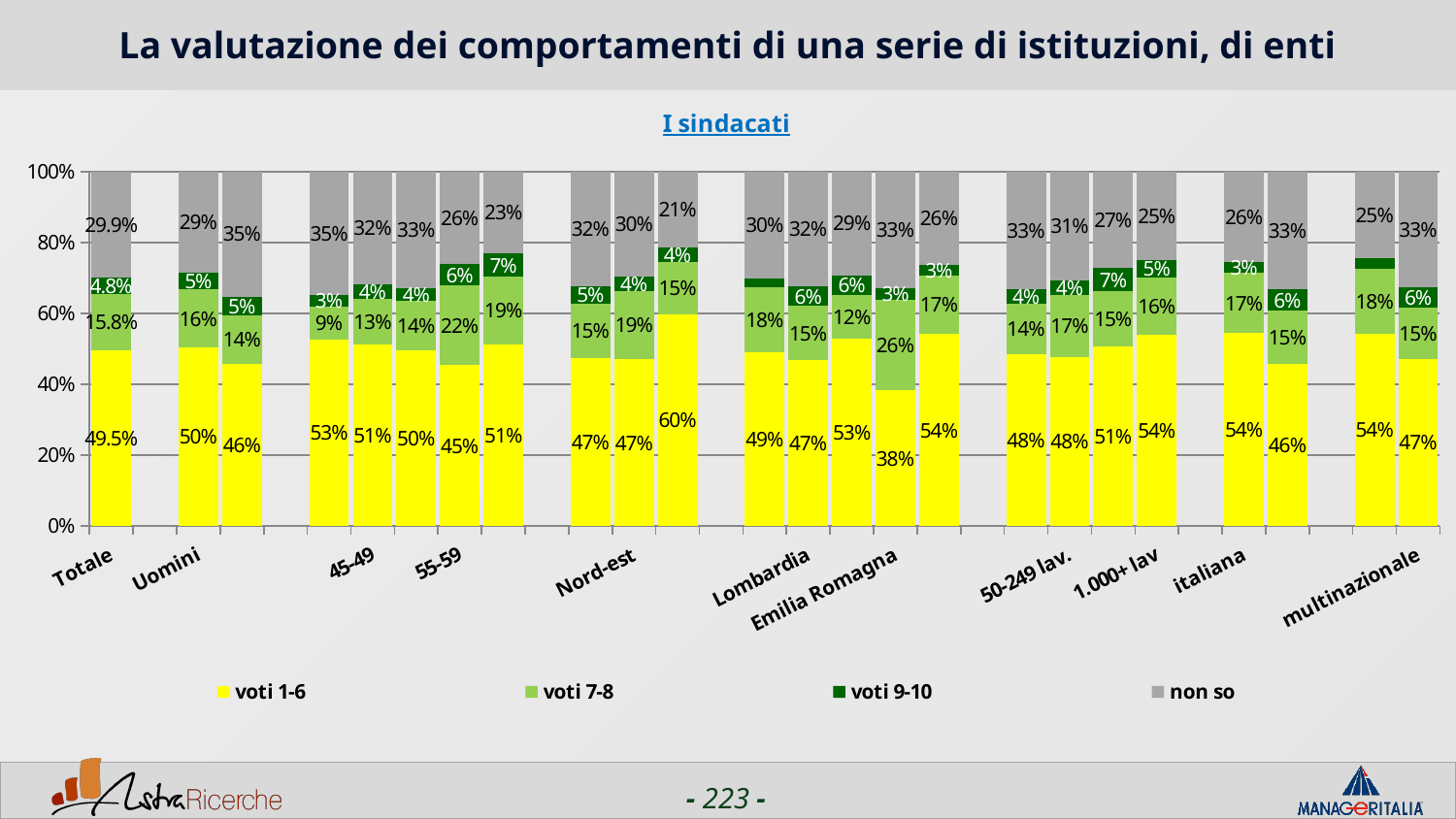
What is the 'non so' value for Totale? 29.9% What is the highest 'voti 1-6' value shown in any bar? 60% What kind of chart is shown on the slide? stacked bar chart Which has the larger 'non so' value, Totale or Uomini? Totale What is the difference between the 'voti 1-6' and 'voti 7-8' values for Totale? 33.7% What is the lowest 'voti 1-6' value shown in any bar? 38% What is the 'voti 7-8' value for Uomini? 16% What are the four legend entries of the chart? voti 1-6, voti 7-8, voti 9-10, non so What is the 'voti 9-10' value for Totale? 4.8% Is the 'voti 1-6' value for Totale greater or less than 40%? greater What is the 'voti 1-6' value for Totale? 49.5% How many series does the legend list? 4